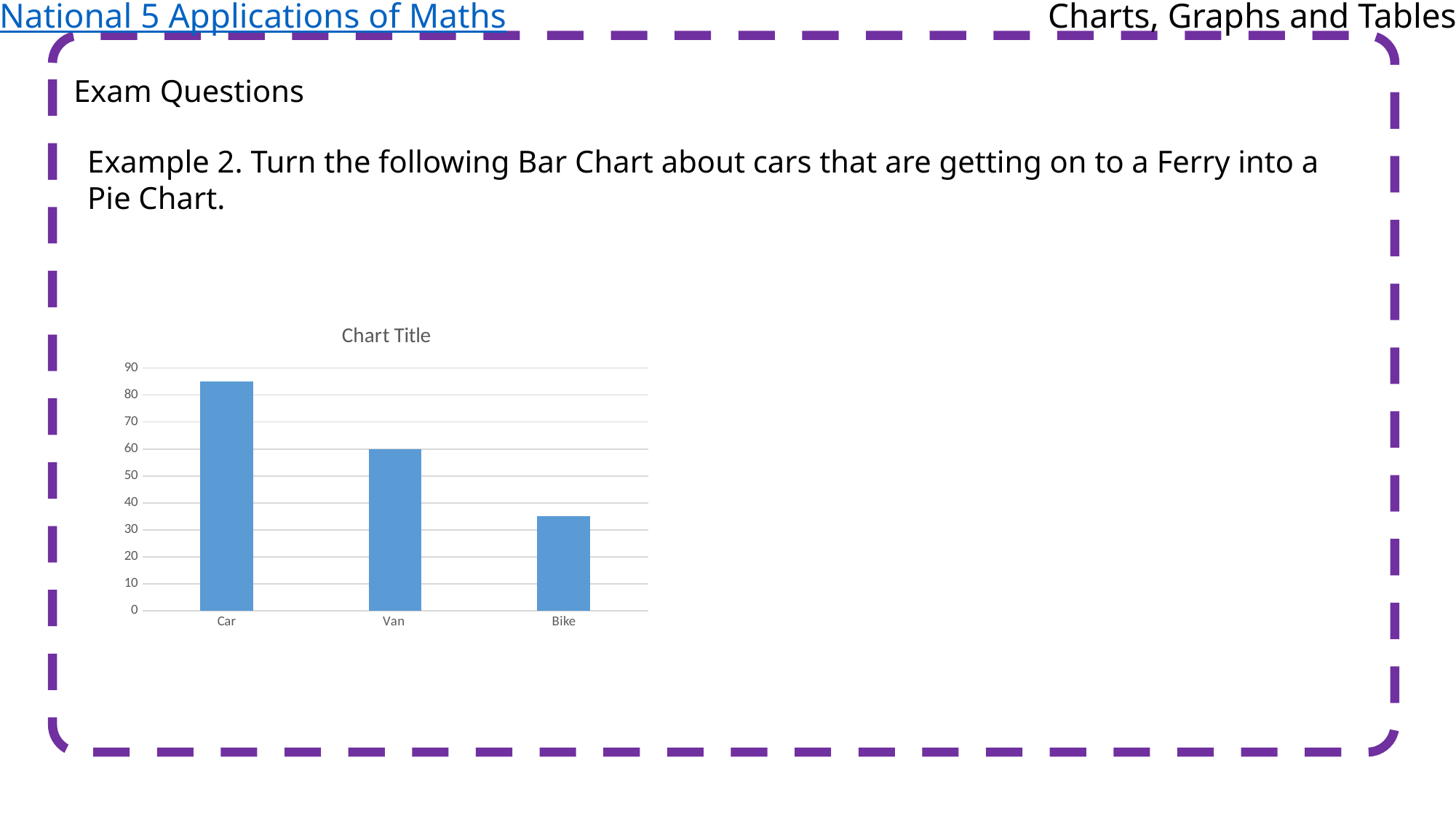
Is the value for Bike greater or less than 40? less Which is larger, the value for Car or the value for Van? Car Which is larger, the value for Van or the value for Bike? Van What kind of chart is shown on the slide? bar chart How many categories are shown on the x axis? 3 What is the value for Van? 60 Do the values rise or fall from left to right along the x axis? fall Is the value for Car greater or less than 90? less Is the value for Car greater or less than 80? greater Which category has the lowest value? Bike Which category has the highest value? Car